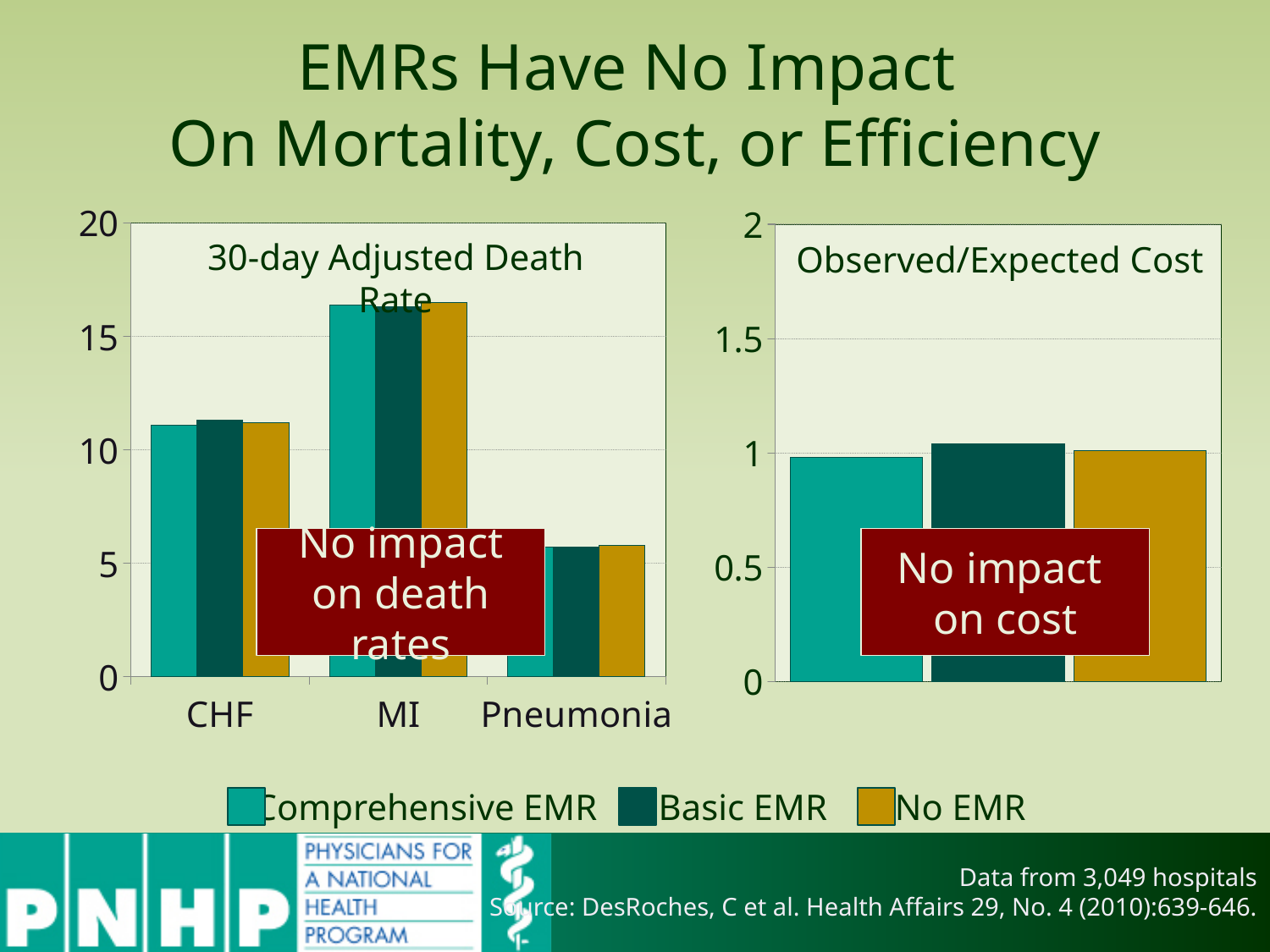
What are the three legend entries shown on the slide? Comprehensive EMR, Basic EMR, No EMR In the 30-day Adjusted Death Rate chart, which category has the lowest No EMR value? Pneumonia In the 30-day Adjusted Death Rate chart, is the Comprehensive EMR value for CHF greater or less than 10? greater In the 30-day Adjusted Death Rate chart, is the Basic EMR value for Pneumonia greater or less than 10? less What kind of chart is the 30-day Adjusted Death Rate chart? bar chart In the 30-day Adjusted Death Rate chart, which category has the highest Comprehensive EMR value? MI In the 30-day Adjusted Death Rate chart, is the No EMR value for MI greater or less than 15? greater How many categories are shown on the x axis of the 30-day Adjusted Death Rate chart? 3 How many series does the legend list? 3 In the 30-day Adjusted Death Rate chart, which is larger for Basic EMR: MI or CHF? MI What is the title of the chart on the right side of the slide? Observed/Expected Cost